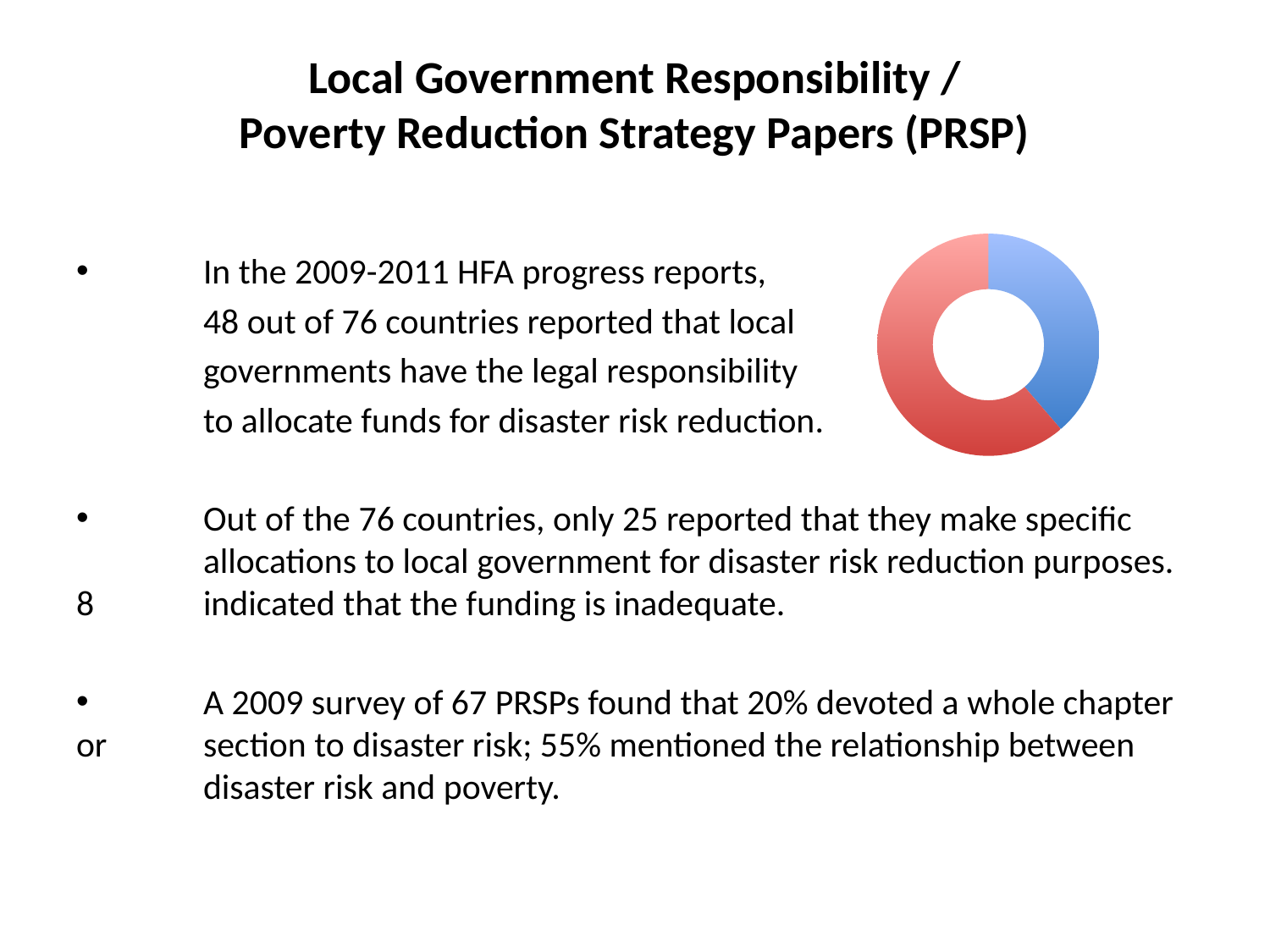
How many slices does the doughnut chart have? 2 Which slice of the doughnut chart is the smallest? the blue slice What kind of chart is shown on the slide? doughnut chart What two colours are used for the slices of the doughnut chart? red and blue Does the doughnut chart display a legend? No Which slice of the doughnut chart is larger, the red one or the blue one? the red one Which slice of the doughnut chart is the largest? the red slice